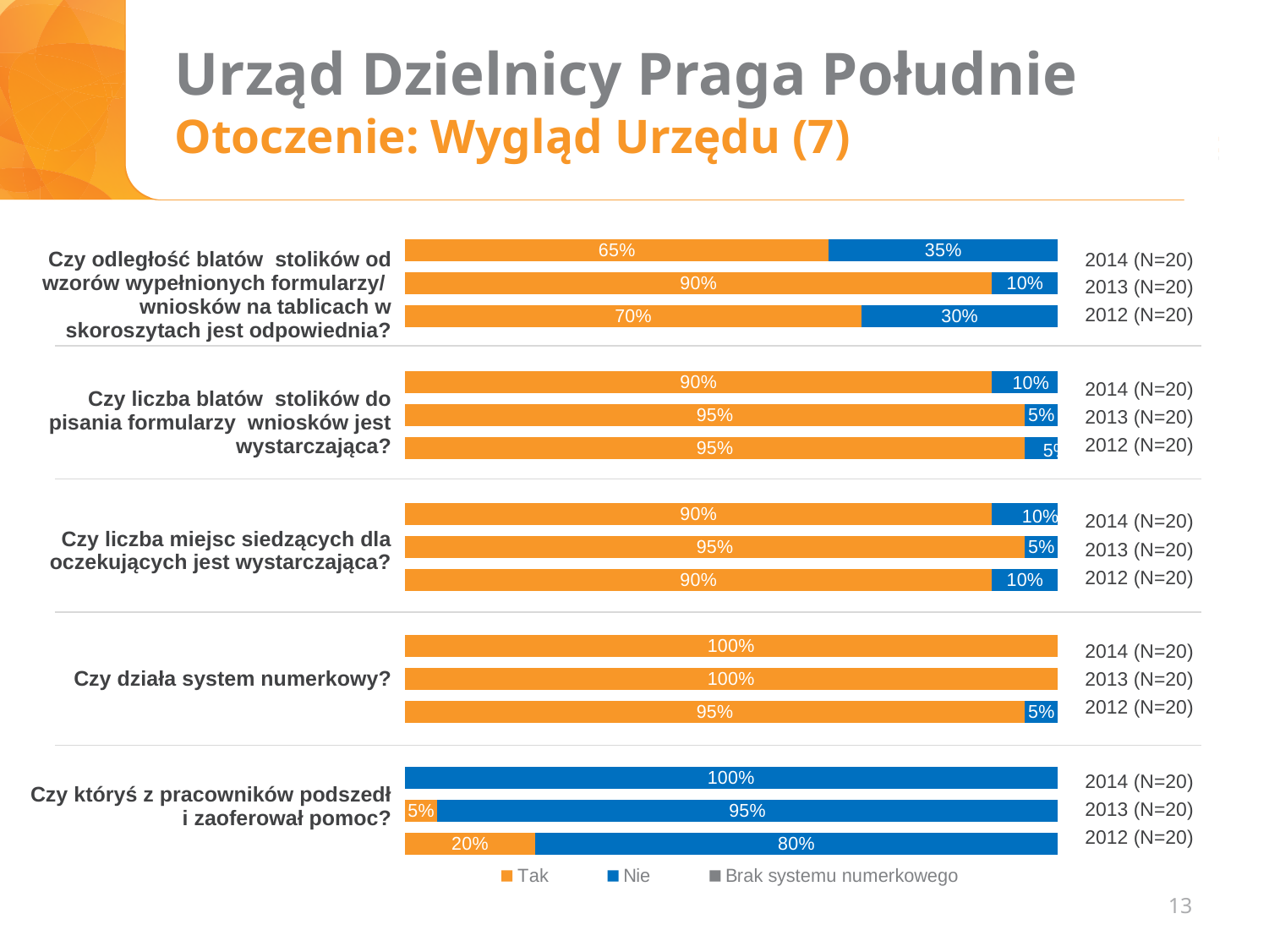
For the question "Czy odległość blatów stolików od wzorów wypełnionych formularzy/wniosków na tablicach w skoroszytach jest odpowiednia?", which year has the larger "Tak" value, 2013 or 2012? 2013 For the question "Czy działa system numerkowy?", what is the "Nie" value for 2012 (N=20)? 5% What kind of chart is shown on the slide? Stacked bar chart For the question "Czy odległość blatów stolików od wzorów wypełnionych formularzy/wniosków na tablicach w skoroszytach jest odpowiednia?", what is the "Nie" value for 2014 (N=20)? 35% For the question "Czy liczba blatów stolików do pisania formularzy wniosków jest wystarczająca?", what is the "Tak" value for 2013 (N=20)? 95% For the question "Czy liczba miejsc siedzących dla oczekujących jest wystarczająca?", what is the "Nie" value for 2012 (N=20)? 10% For the question "Czy któryś z pracowników podszedł i zaoferował pomoc?", what is the "Tak" value for 2013 (N=20)? 5% For the question "Czy któryś z pracowników podszedł i zaoferował pomoc?", what is the "Nie" value for 2012 (N=20)? 80% How many series does the legend of the chart list? 3 Which colour represents the "Tak" series in the chart? Orange For the question "Czy odległość blatów stolików od wzorów wypełnionych formularzy/wniosków na tablicach w skoroszytach jest odpowiednia?", what is the "Tak" value for 2014 (N=20)? 65% For the question "Czy odległość blatów stolików od wzorów wypełnionych formularzy/wniosków na tablicach w skoroszytach jest odpowiednia?", what is the difference between the "Tak" values for 2013 and 2014? 25 percentage points